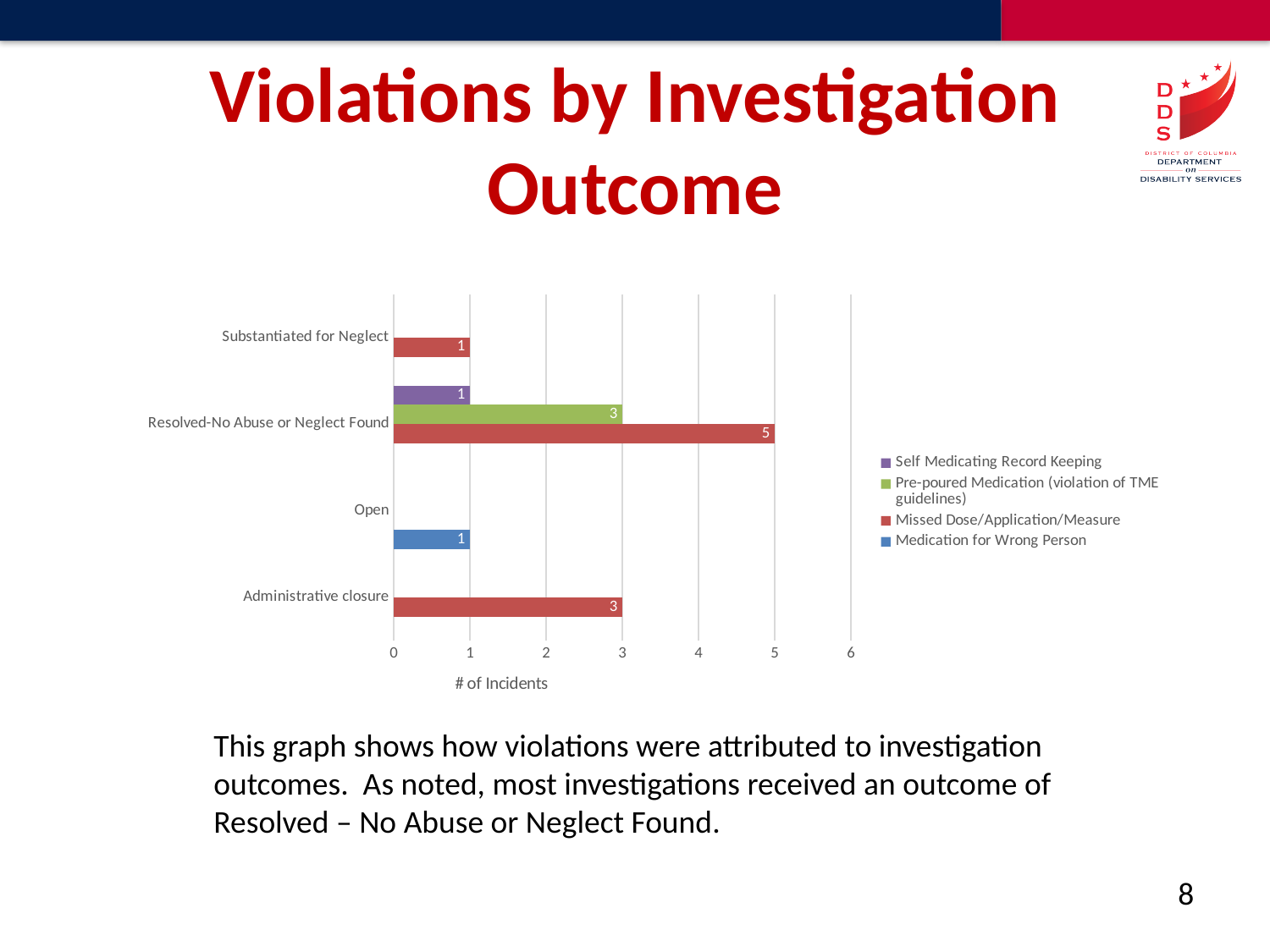
What is the value for Missed Dose/Application/Measure in the Resolved-No Abuse or Neglect Found category? 5 What is the value for Medication for Wrong Person in the Open category? 1 What is the value for Missed Dose/Application/Measure in the Administrative closure category? 3 How many series does the legend list? 4 How many investigation outcome categories are shown on the vertical axis? 4 Which category has the highest single bar value? Resolved-No Abuse or Neglect Found What is the value for Pre-poured Medication (violation of TME guidelines) in the Resolved-No Abuse or Neglect Found category? 3 Which series is shown in red in the legend? Missed Dose/Application/Measure What is the difference between the Missed Dose/Application/Measure values for Resolved-No Abuse or Neglect Found and Administrative closure? 2 What type of chart is shown on the slide? bar chart What is the label of the horizontal axis? # of Incidents Which is larger: the Missed Dose/Application/Measure value for Substantiated for Neglect or for Administrative closure? Administrative closure